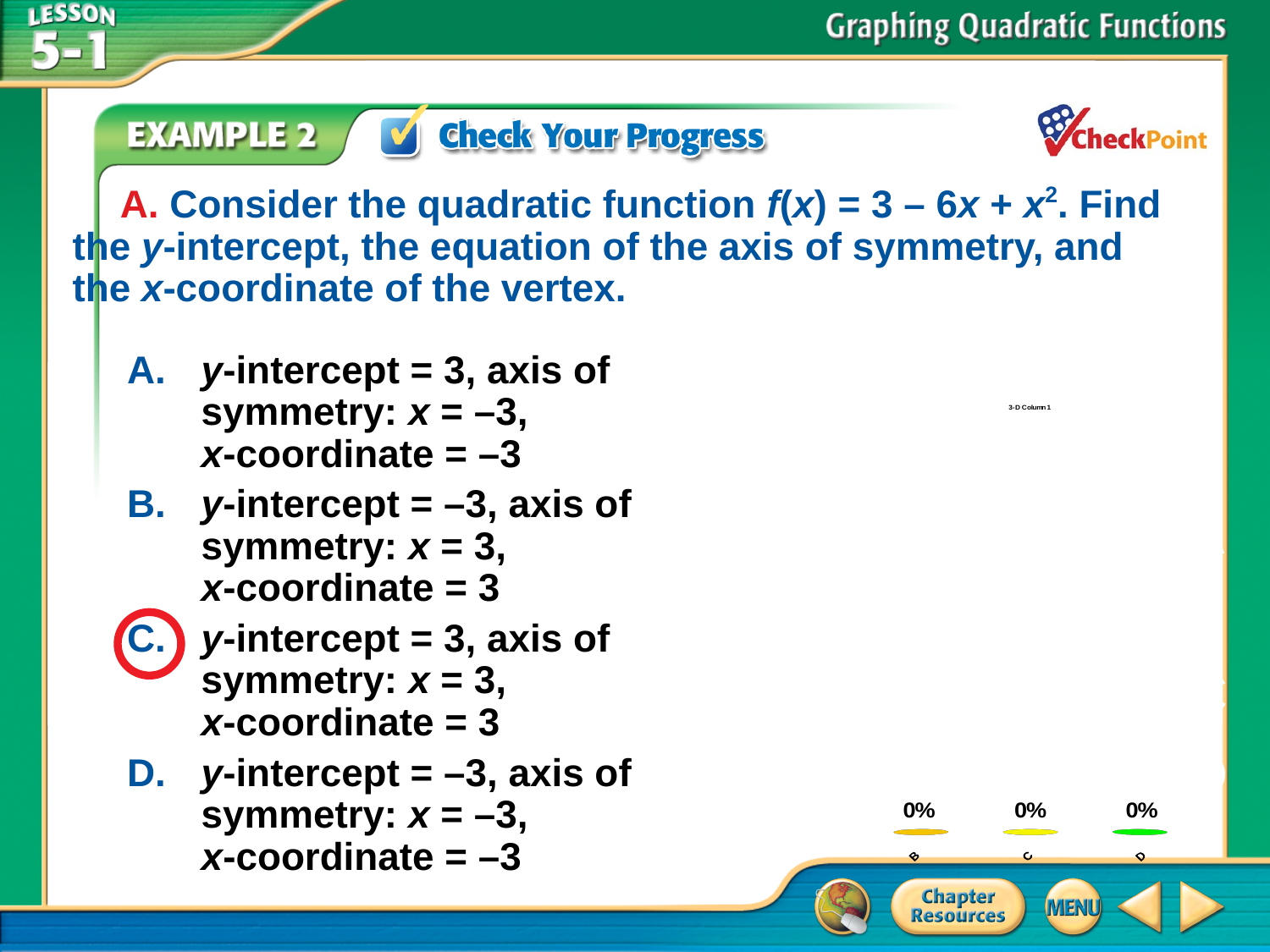
What is the value shown for category D in the chart? 0% What is the value shown for category B in the chart? 0% What is the title of the chart on the slide? 3-D Column 1 What kind of chart is shown on the slide? bar chart What is the value shown for category C in the chart? 0% Is the value for category C greater or less than 50%? less